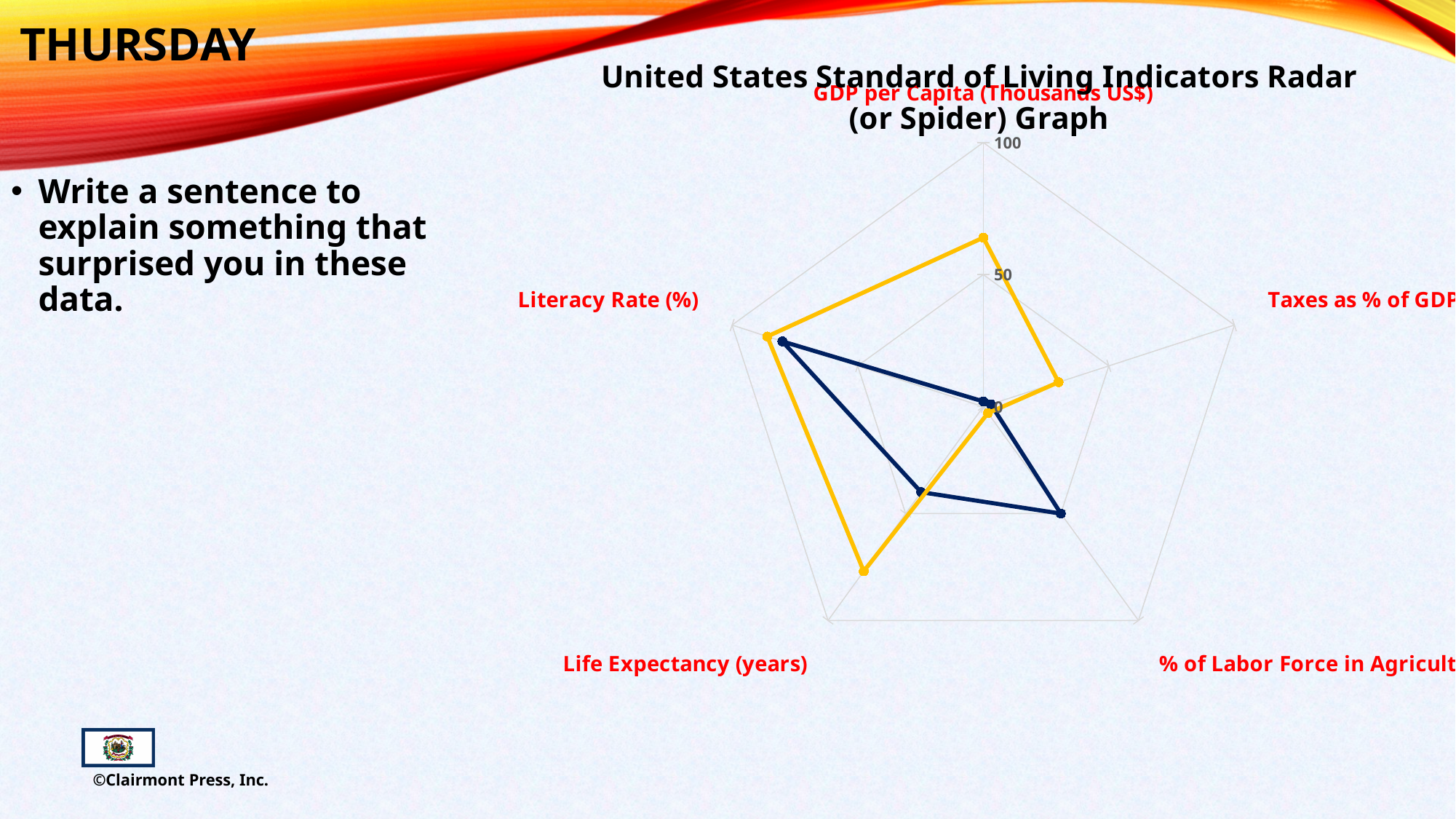
How many indicator axes (categories) does the radar chart have? 5 Is the yellow line's value for Taxes as % of GDP greater or less than 50? less What is the title of the chart? United States Standard of Living Indicators Radar (or Spider) Graph Is the yellow line's value for Literacy Rate (%) greater or less than 50? greater Is the dark blue line's value for Literacy Rate (%) greater or less than 50? greater What kind of chart is shown on the slide? Radar chart For Life Expectancy (years), which line has the larger value, the yellow line or the dark blue line? Yellow line What is the highest value shown on the radar chart's axis scale? 100